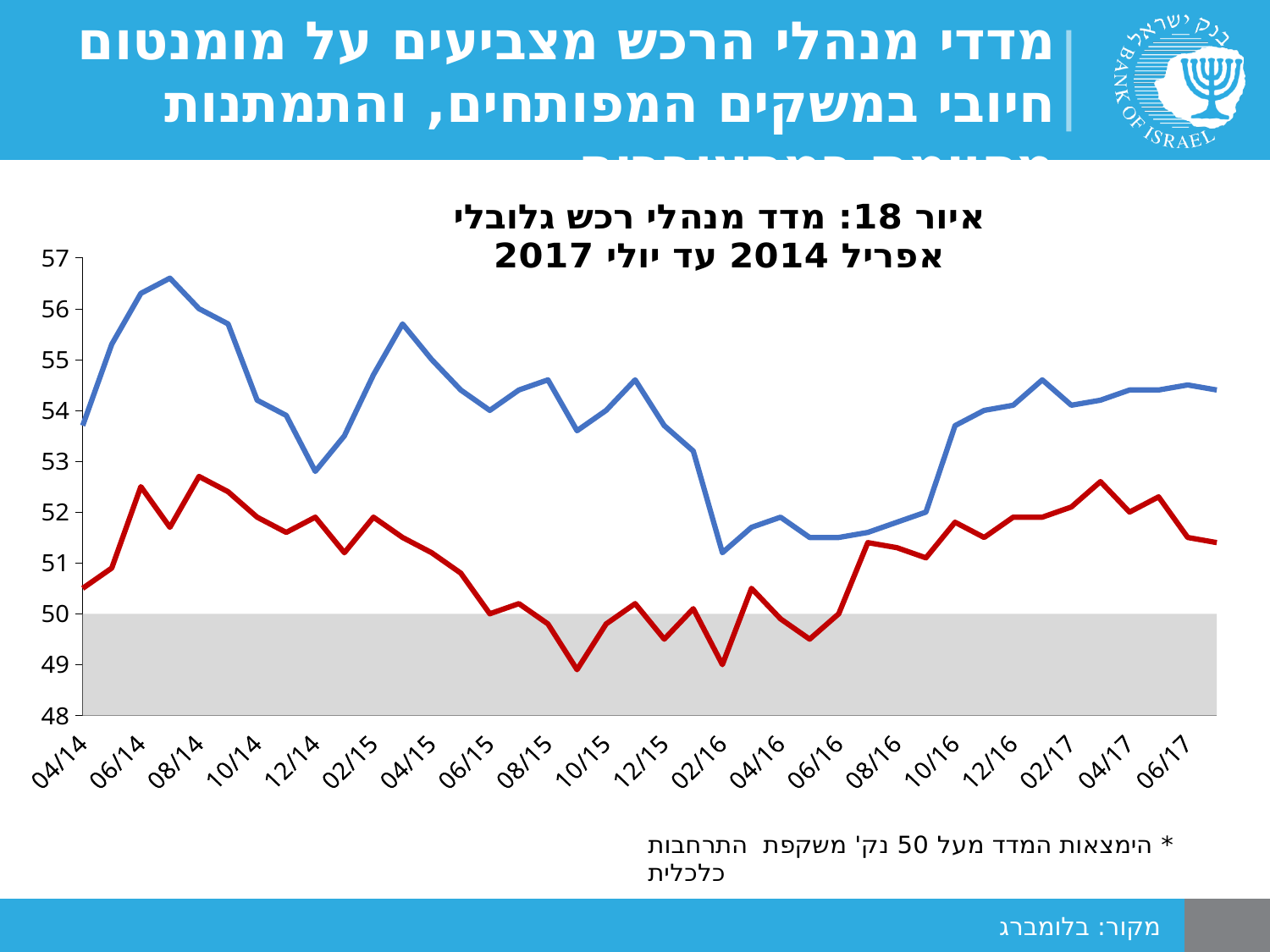
Is the value of the blue line at 06/17 greater or less than 54? greater What kind of chart is shown on the slide? Line chart How many lines are plotted on the chart? 2 Is the value of the red line at 10/15 greater or less than 50? less Is the value of the red line at 08/14 greater or less than 52? greater At 04/14, which line has the higher value, the blue line or the red line? The blue line What is the title of the chart? איור 18: מדד מנהלי רכש גלובלי אפריל 2014 עד יולי 2017 At 06/16, which line has the higher value, the blue line or the red line? The blue line Does the blue line rise or fall between 04/14 and 06/14? Rise What is the highest value shown on the vertical axis? 57